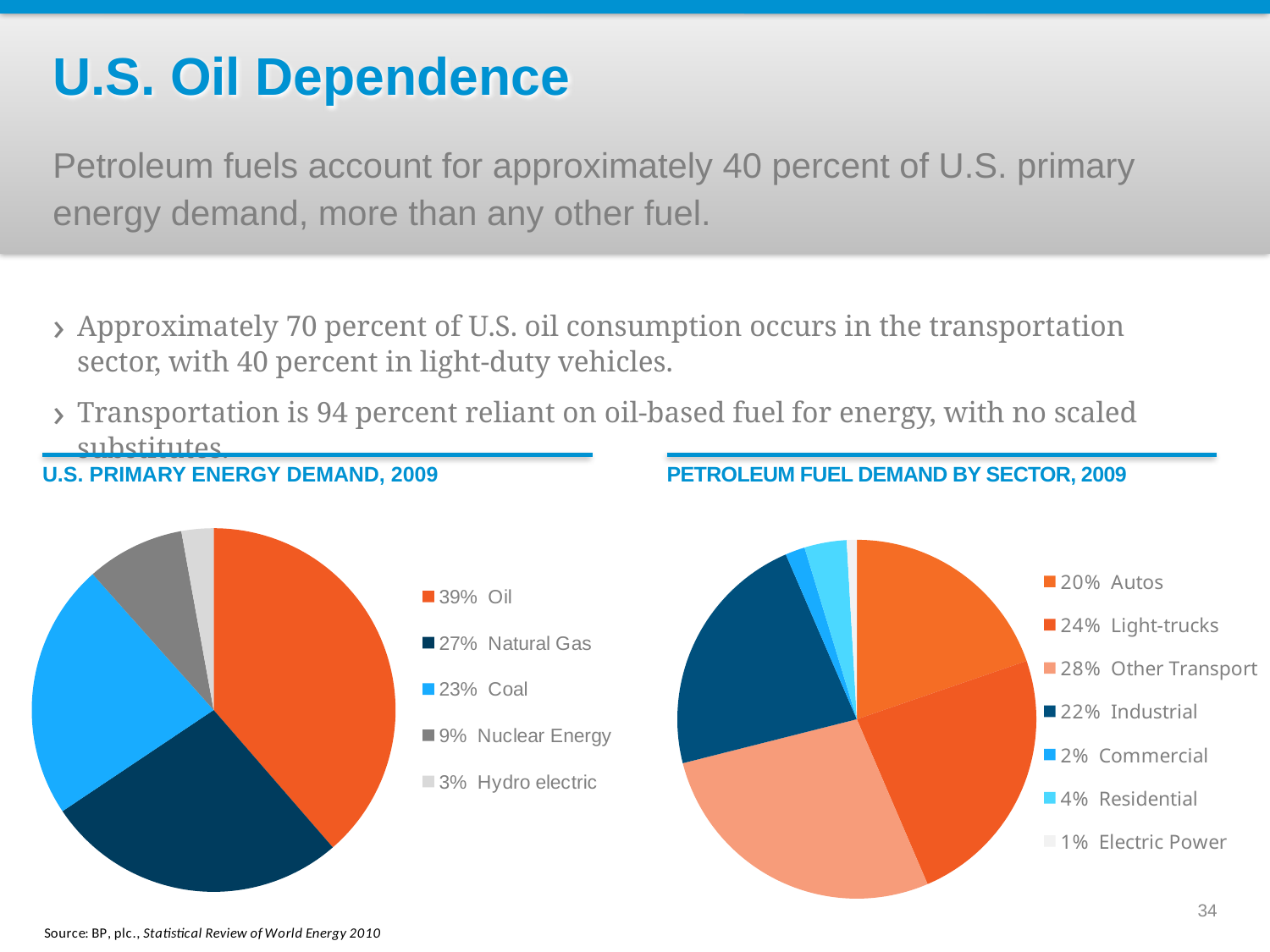
In the 'U.S. Primary Energy Demand, 2009' chart, which fuel has the smallest share? Hydro electric In the 'Petroleum Fuel Demand by Sector, 2009' chart, what share does Other Transport account for? 28% In the 'U.S. Primary Energy Demand, 2009' chart, what share does Natural Gas account for? 27% What type of chart is used for 'Petroleum Fuel Demand by Sector, 2009'? Pie chart In the 'U.S. Primary Energy Demand, 2009' chart, what is the difference in percentage points between Coal and Nuclear Energy? 14 In the 'Petroleum Fuel Demand by Sector, 2009' chart, how many sectors are listed in the legend? 7 In the 'Petroleum Fuel Demand by Sector, 2009' chart, which sector has the largest share? Other Transport In the 'U.S. Primary Energy Demand, 2009' chart, what share does Oil account for? 39% In the 'U.S. Primary Energy Demand, 2009' chart, which fuel has the largest share? Oil In the 'Petroleum Fuel Demand by Sector, 2009' chart, which is larger, Autos or Light-trucks? Light-trucks In the 'Petroleum Fuel Demand by Sector, 2009' chart, which sector has the smallest share? Electric Power In the 'U.S. Primary Energy Demand, 2009' chart, how many fuel categories are shown? 5